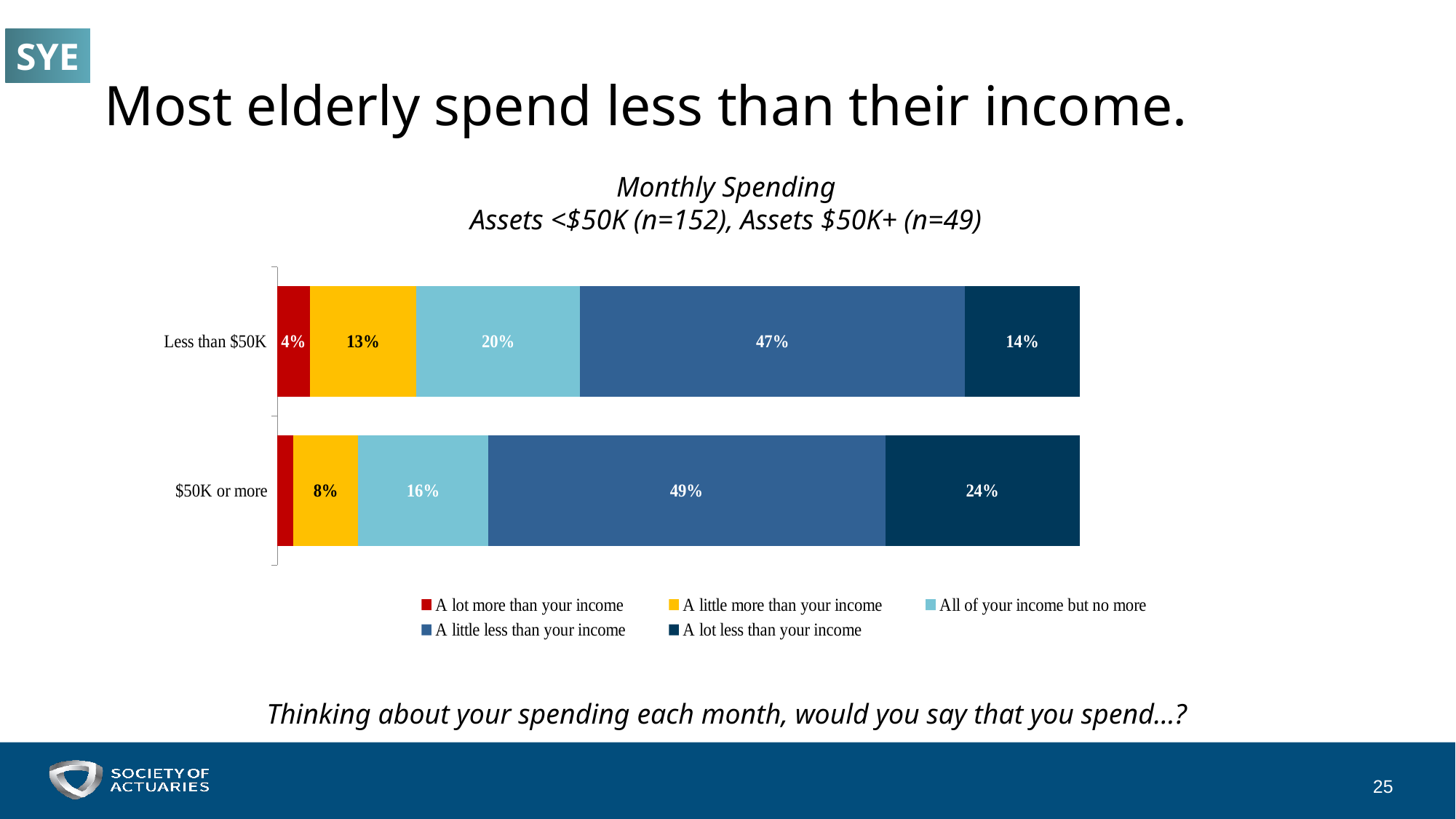
How many asset groups are shown on the chart? 2 Which group has a larger share spending all of their income but no more: Less than $50K or $50K or more? Less than $50K Which response has the largest share for the $50K or more group? A little less than your income What percentage of the $50K or more group spend a lot less than their income? 24% What kind of chart is shown on the slide? Stacked bar chart What percentage of the $50K or more group spend all of their income but no more? 16% What is the total of the labelled segments for the Less than $50K bar? 98% What percentage of the Less than $50K group spend a little more than their income? 13% What percentage of the Less than $50K group spend a little less than their income? 47% What is the difference between the 'A lot less than your income' shares for the $50K or more group and the Less than $50K group? 10% How many series does the legend list? 5 Which response has the smallest share for the Less than $50K group? A lot more than your income